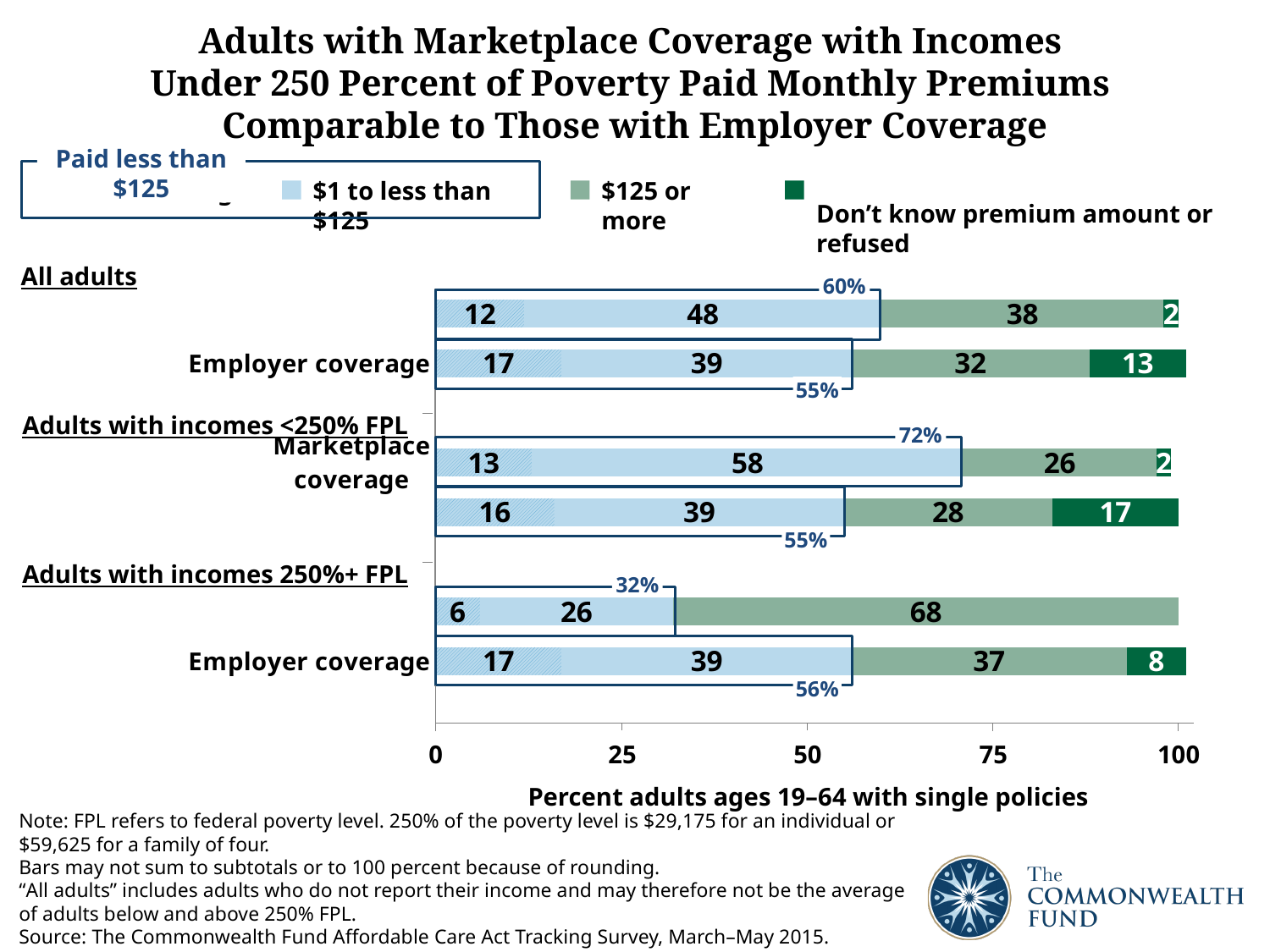
What kind of chart is shown on the slide? Stacked bar chart What is the largest value shown for the $125 or more segment across all bars? 68 Under Adults with incomes <250% FPL, what percentage of adults with Marketplace coverage paid $1 to less than $125? 58 For the $125 or more segment, which Employer coverage bar is larger: the one under All adults or the one under Adults with incomes 250%+ FPL? Adults with incomes 250%+ FPL What is the title of the horizontal axis? Percent adults ages 19–64 with single policies How many bars are plotted on the chart? 6 What is the difference between the 'Don't know premium amount or refused' values for Employer coverage under All adults (13) and under Adults with incomes 250%+ FPL (8)? 5 Under All adults, what percentage of adults with Employer coverage did not know the premium amount or refused? 13 What subtotal is shown for adults with Marketplace coverage under Adults with incomes <250% FPL who paid less than $125? 72% Under Adults with incomes <250% FPL, what is the difference between the 'paid less than $125' subtotals of the Marketplace coverage bar (72%) and the bar below it (55%)? 17 percentage points Under All adults, what percentage of adults with Employer coverage paid $125 or more? 32 Under Adults with incomes 250%+ FPL, what percentage of adults with Employer coverage did not know the premium amount or refused? 8